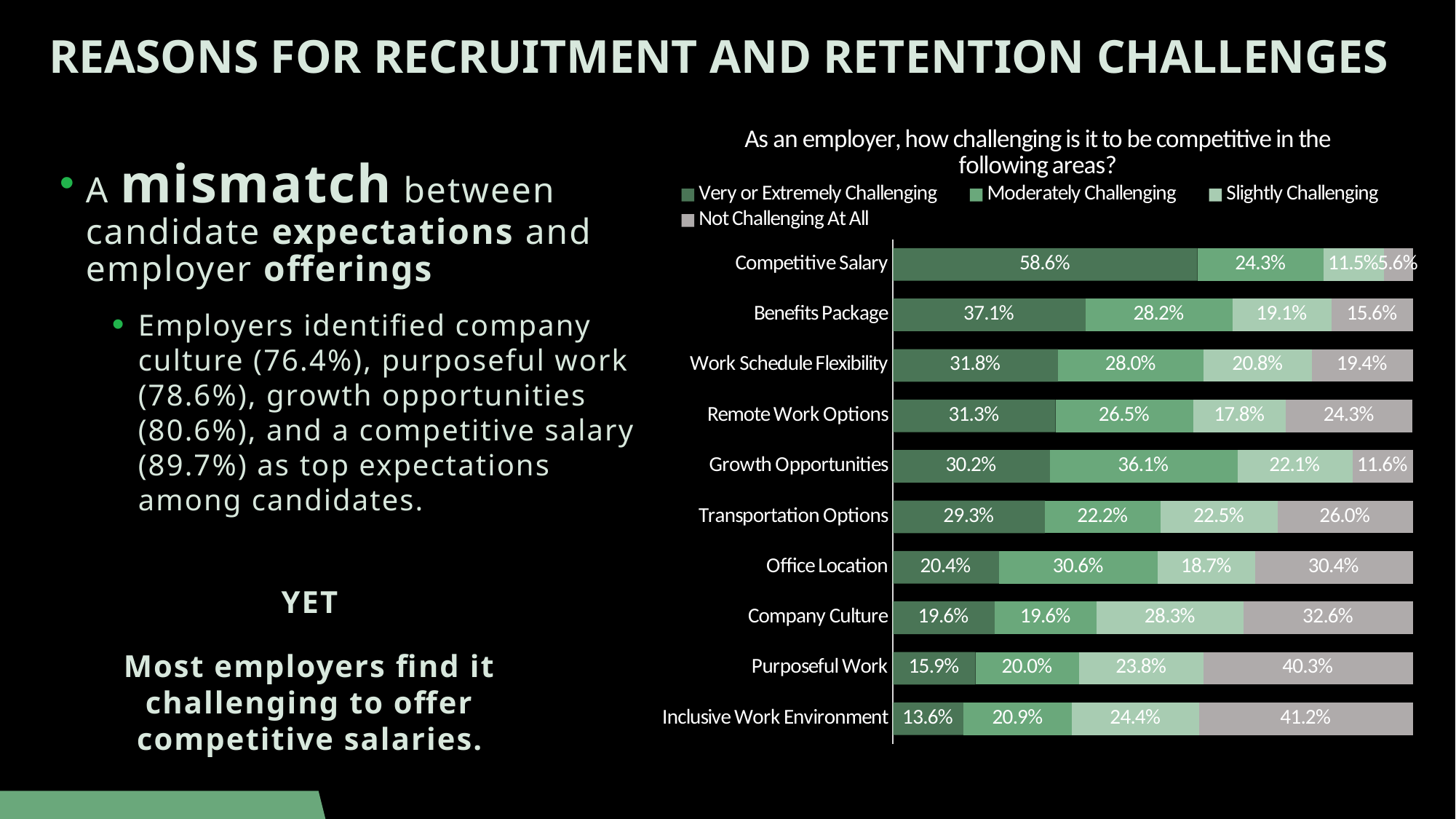
Which category has the lowest Very or Extremely Challenging percentage? Inclusive Work Environment Which category has the highest Very or Extremely Challenging percentage? Competitive Salary Which has a larger Moderately Challenging value, Growth Opportunities or Office Location? Growth Opportunities Which category has the highest Not Challenging At All percentage? Inclusive Work Environment What is the Moderately Challenging value for Growth Opportunities? 36.1% What kind of chart is shown on the slide? Stacked bar chart How many categories are shown in the chart? 10 What is the difference between the Very or Extremely Challenging values for Competitive Salary and Benefits Package? 21.5% What is the Not Challenging At All value for Purposeful Work? 40.3% What percentage of employers rated Competitive Salary as Very or Extremely Challenging? 58.6% What is the total of the stacked bar for Benefits Package? 100.0% How many series does the legend list? 4